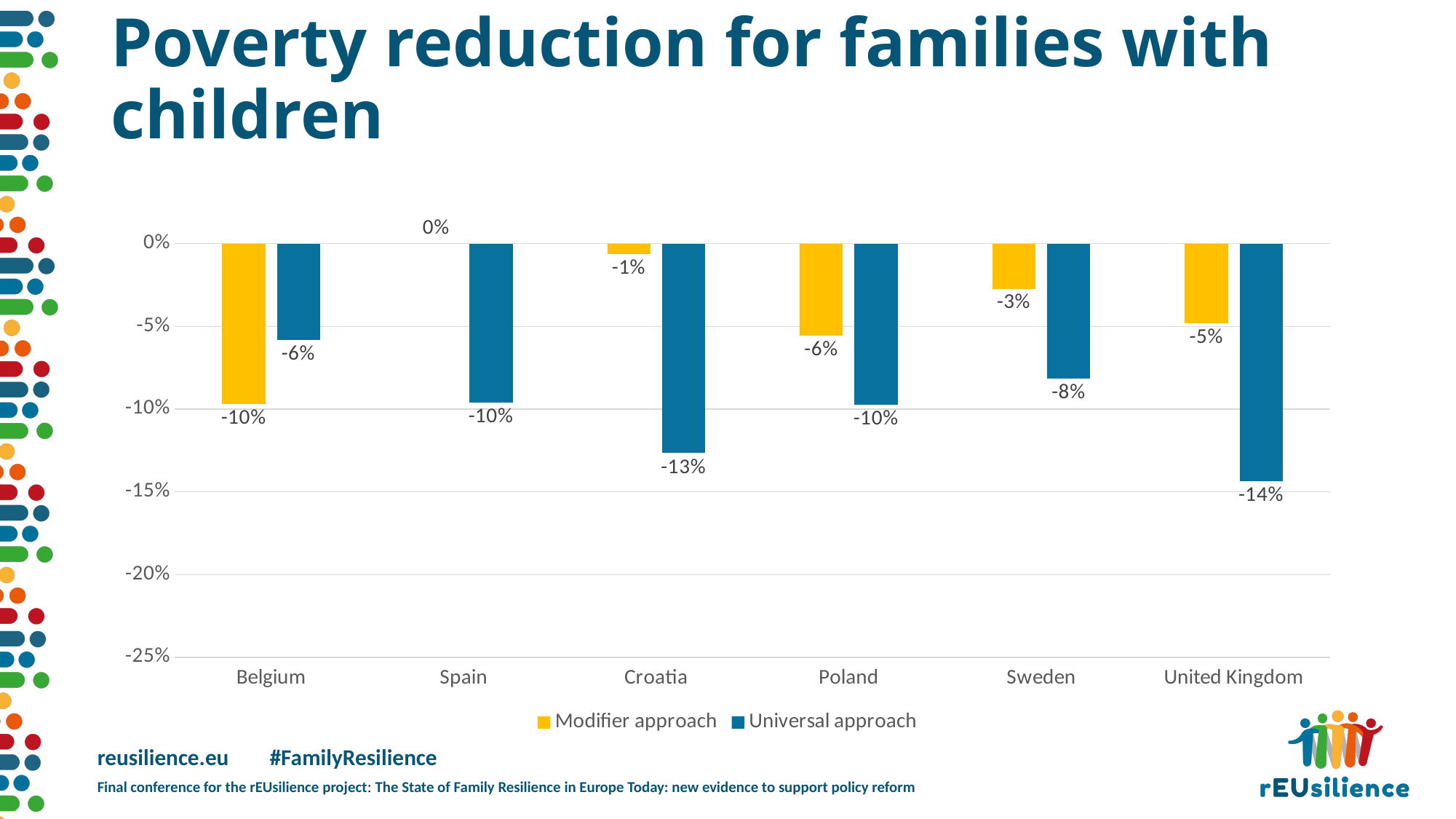
What is the value for the Modifier approach in Belgium? -10% How many series does the legend list? 2 Which country has the lowest (most negative) value for the Universal approach? United Kingdom How many countries are shown on the x axis? 6 Which country has the highest value for the Modifier approach? Spain What is the value for the Universal approach in Croatia? -13% Which is lower (more negative) for Poland: the Modifier approach or the Universal approach? Universal approach Which colour represents the Modifier approach in the legend? Yellow What is the difference between the Modifier approach and Universal approach values for Belgium? 4 percentage points What kind of chart is shown on the slide? Bar chart What is the value for the Universal approach in Sweden? -8% What is the value for the Modifier approach in Spain? 0%